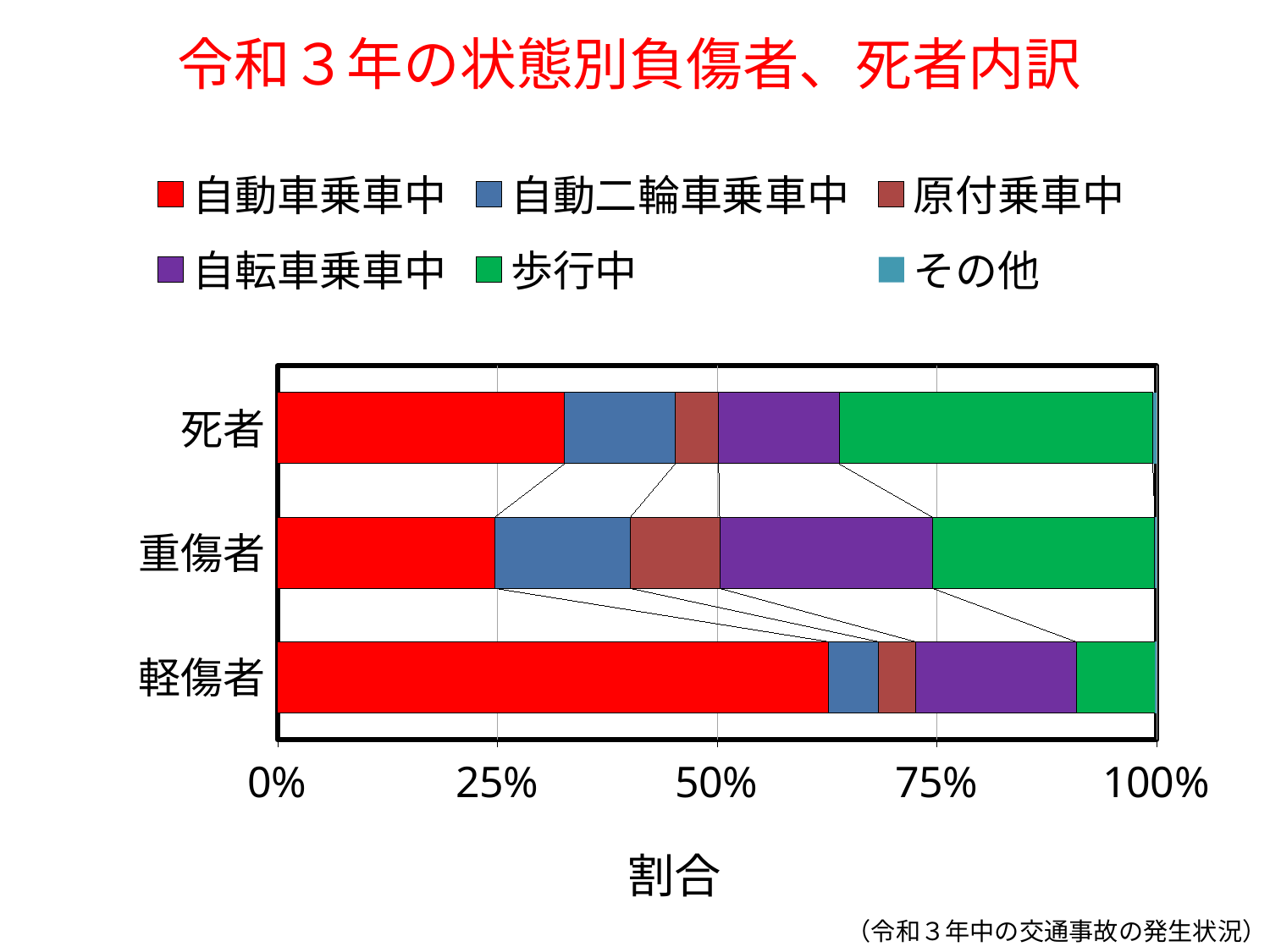
Is the 歩行中 share for 死者 greater or less than 25%? greater Is the 歩行中 share for 軽傷者 greater or less than 25%? less What is the label of the x axis? 割合 How many series does the legend list? 6 What kind of chart is shown on the slide? Stacked bar chart Is the 自動車乗車中 share for 軽傷者 greater or less than 50%? greater Which category has the smallest 歩行中 share? 軽傷者 What is the title of the chart? 令和３年の状態別負傷者、死者内訳 Which category has the largest 歩行中 share? 死者 How many categories (bars) are shown on the y axis of the chart? 3 Which category has the largest 自動車乗車中 share: 死者 or 軽傷者? 軽傷者